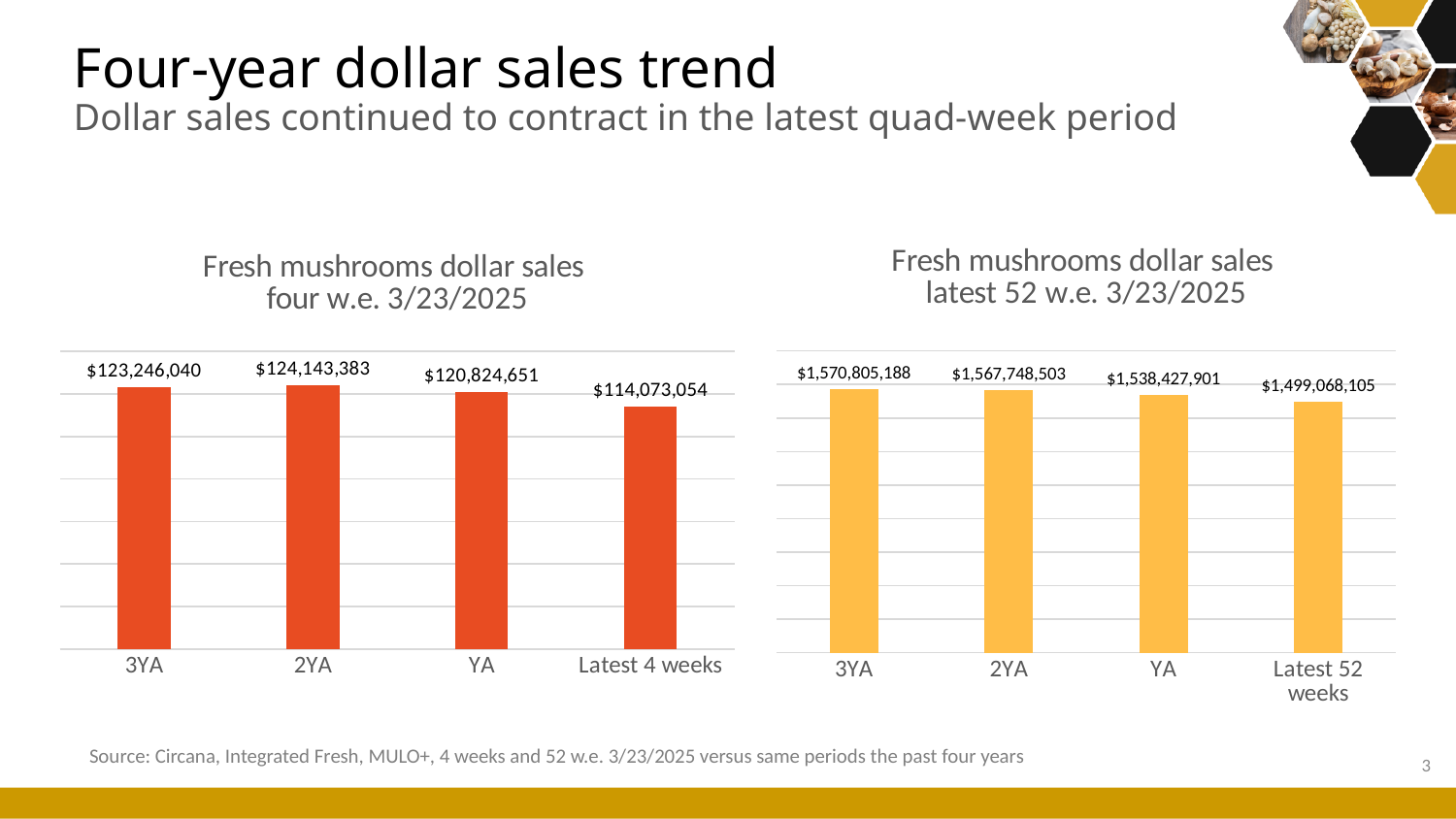
In the 'Fresh mushrooms dollar sales latest 52 w.e. 3/23/2025' chart, which category has the lowest value? Latest 52 weeks In the 'Fresh mushrooms dollar sales latest 52 w.e. 3/23/2025' chart, what is the value for Latest 52 weeks? $1,499,068,105 In the 'Fresh mushrooms dollar sales latest 52 w.e. 3/23/2025' chart, what is the difference between the 3YA value and the Latest 52 weeks value? $71,737,083 In the 'Fresh mushrooms dollar sales four w.e. 3/23/2025' chart, what is the value for Latest 4 weeks? $114,073,054 In the 'Fresh mushrooms dollar sales four w.e. 3/23/2025' chart, which is larger, the value for YA or the value for Latest 4 weeks? YA In the 'Fresh mushrooms dollar sales latest 52 w.e. 3/23/2025' chart, do the values rise or fall from 3YA to Latest 52 weeks? Fall How many categories are shown in the 'Fresh mushrooms dollar sales latest 52 w.e. 3/23/2025' chart? 4 In the 'Fresh mushrooms dollar sales four w.e. 3/23/2025' chart, what is the value for 3YA? $123,246,040 In the 'Fresh mushrooms dollar sales latest 52 w.e. 3/23/2025' chart, what is the value for YA? $1,538,427,901 In the 'Fresh mushrooms dollar sales four w.e. 3/23/2025' chart, which category has the highest value? 2YA In the 'Fresh mushrooms dollar sales four w.e. 3/23/2025' chart, what is the difference between the 2YA value and the Latest 4 weeks value? $10,070,329 What kind of chart is the 'Fresh mushrooms dollar sales four w.e. 3/23/2025' chart? Bar chart